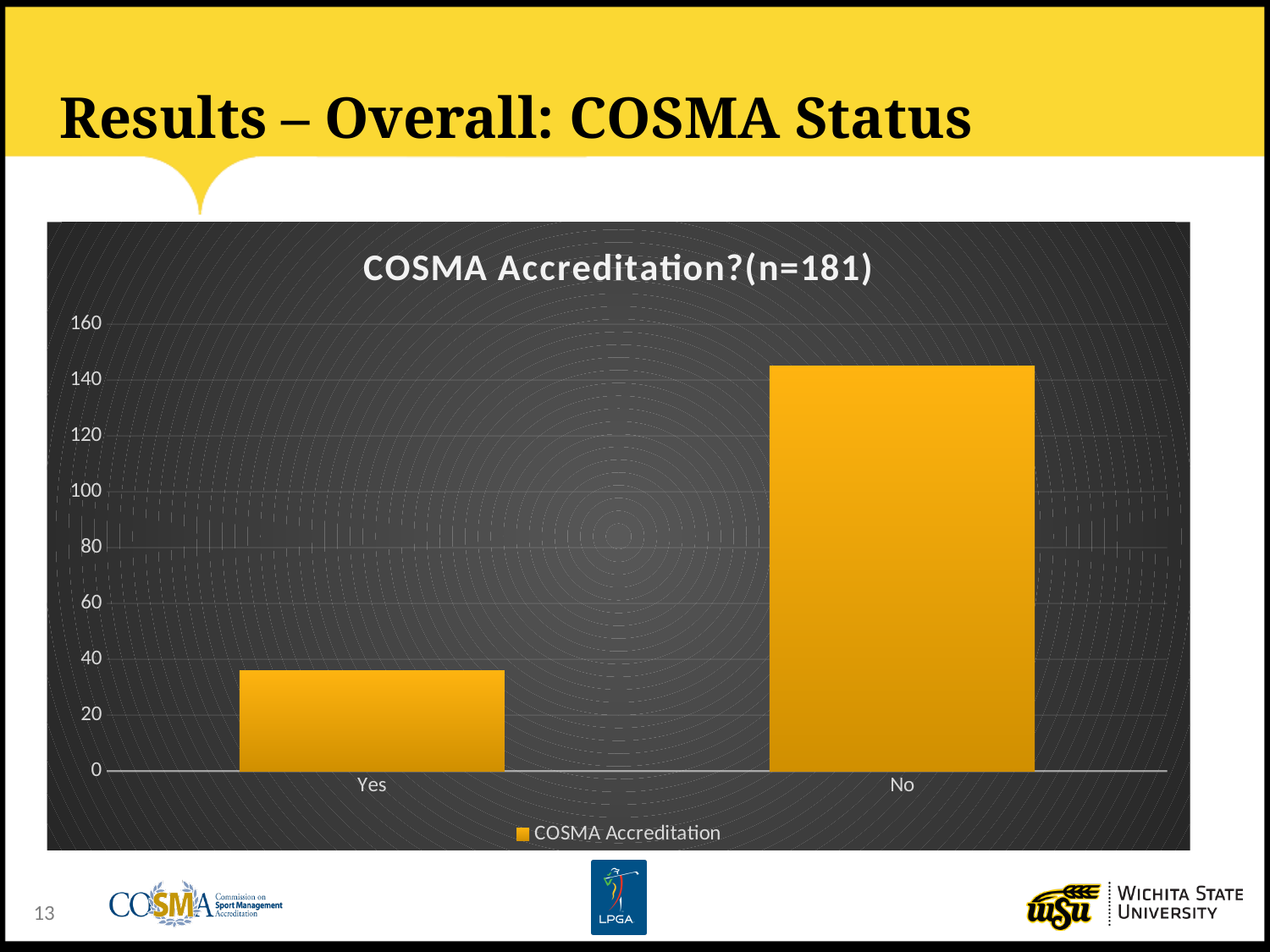
Is the value for No greater or less than 160? less What series name is shown in the chart legend? COSMA Accreditation What is the title of the chart? COSMA Accreditation?(n=181) Which category has the highest bar in the chart? No Is the value for No greater or less than 140? greater How many series does the chart legend list? 1 Is the value for Yes greater or less than 20? greater Which is larger, the value for Yes or the value for No? No What kind of chart is shown on the slide? bar chart Which category has the lowest bar in the chart? Yes How many categories are shown on the x axis of the chart? 2